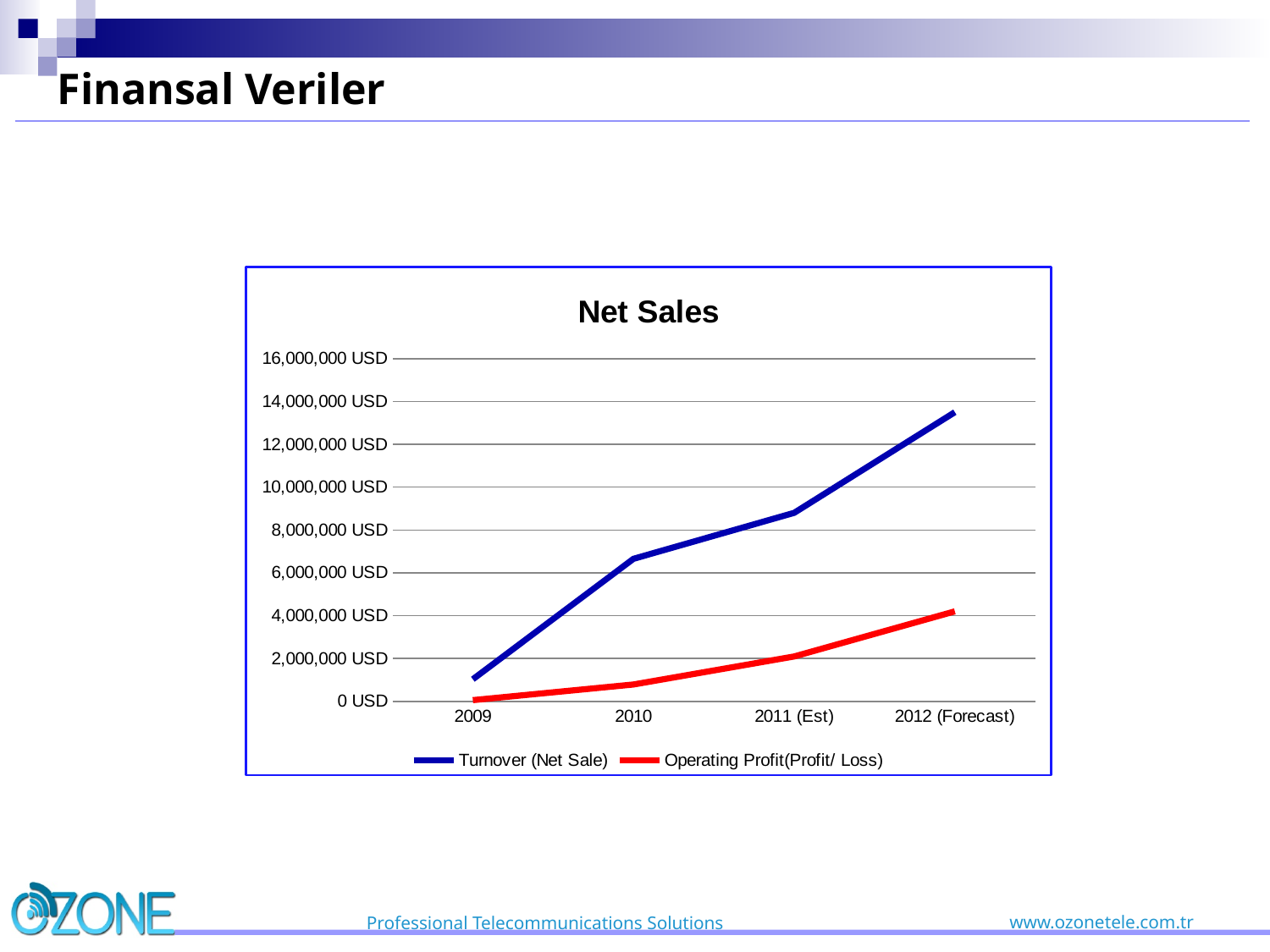
In which year is Turnover (Net Sale) highest? 2012 (Forecast) Is the Turnover (Net Sale) value for 2009 greater or less than 2,000,000 USD? less Which colour is the Turnover (Net Sale) line? blue In 2012 (Forecast), which is larger: Turnover (Net Sale) or Operating Profit(Profit/ Loss)? Turnover (Net Sale) What is the title of the chart? Net Sales How many series does the legend list? 2 Is the Operating Profit(Profit/ Loss) value for 2010 greater or less than 2,000,000 USD? less How many points along the x axis does each line have? 4 In which year is Turnover (Net Sale) lowest? 2009 Does the Operating Profit(Profit/ Loss) line rise or fall from 2009 to 2012 (Forecast)? rise What kind of chart is shown on the slide? line chart Is the Turnover (Net Sale) value for 2012 (Forecast) greater or less than 12,000,000 USD? greater